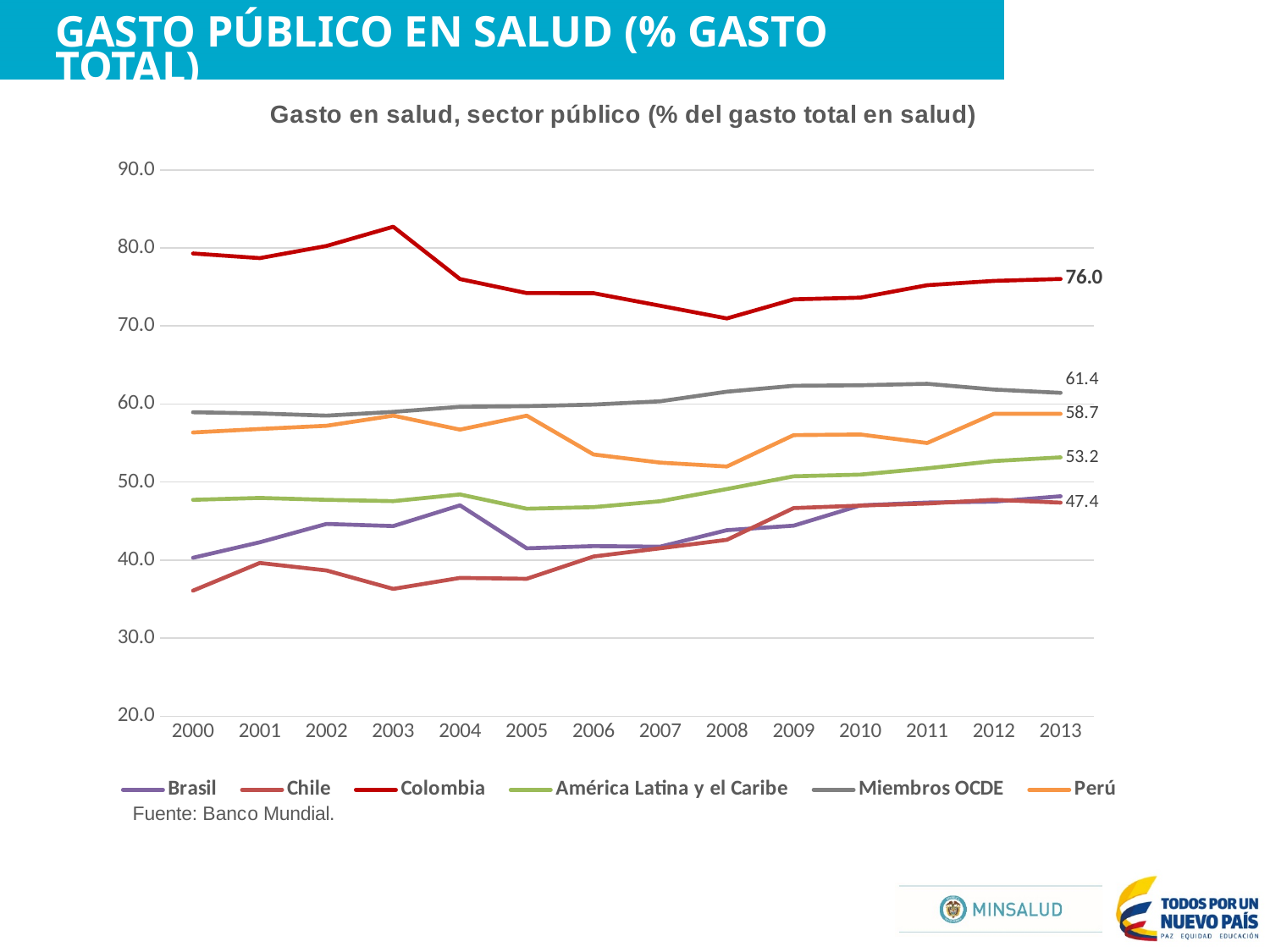
What is the value for Perú in 2013? 58.7 What is the value for Colombia in 2013? 76.0 How many series does the legend list? 6 What is the value for América Latina y el Caribe in 2013? 53.2 What is the value for Miembros OCDE in 2013? 61.4 What is the difference between the 2013 values for Colombia and Miembros OCDE? 14.6 How many years are shown along the x axis? 14 Which series has the highest value in 2013? Colombia What kind of chart is shown on the slide? line chart Is the value for Colombia in 2000 greater or less than 70.0? greater Which is larger in 2013, the value for Perú or the value for América Latina y el Caribe? Perú Is the value for Chile in 2000 greater or less than 40.0? less